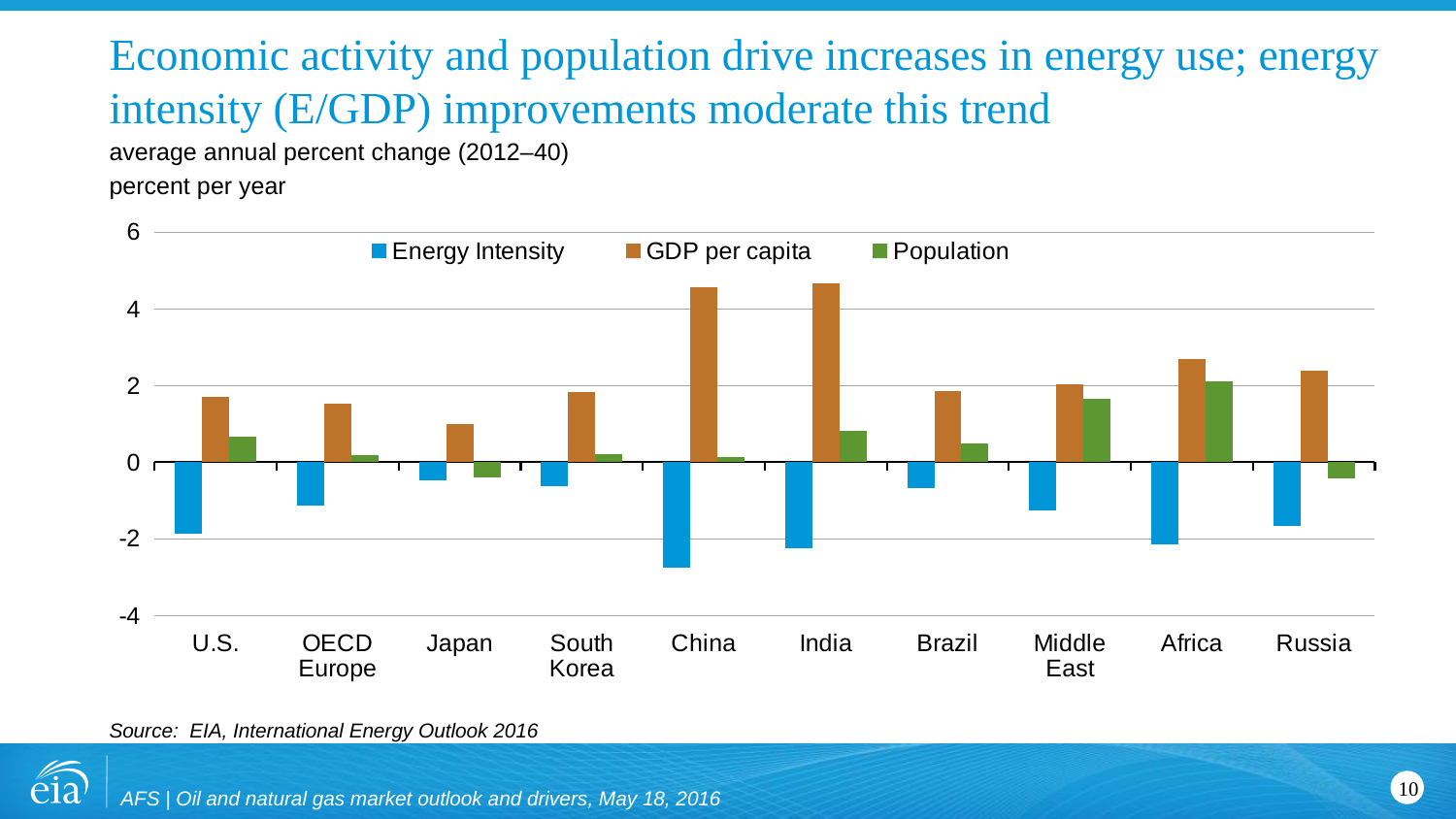
Which colour represents the Energy Intensity series in the legend? blue Which region has the highest Population value? Africa Which has the larger Population value, Africa or the Middle East? Africa How many series does the legend list? 3 Is the GDP per capita value for China greater or less than 4? greater How many regions or countries are shown on the x axis? 10 Is the Energy Intensity value for China greater or less than -2? less Is the Population value for the Middle East greater or less than 2? less Which has the larger GDP per capita value, Brazil or Japan? Brazil What kind of chart is shown on the slide? bar chart Which region has the lowest (most negative) Energy Intensity value? China